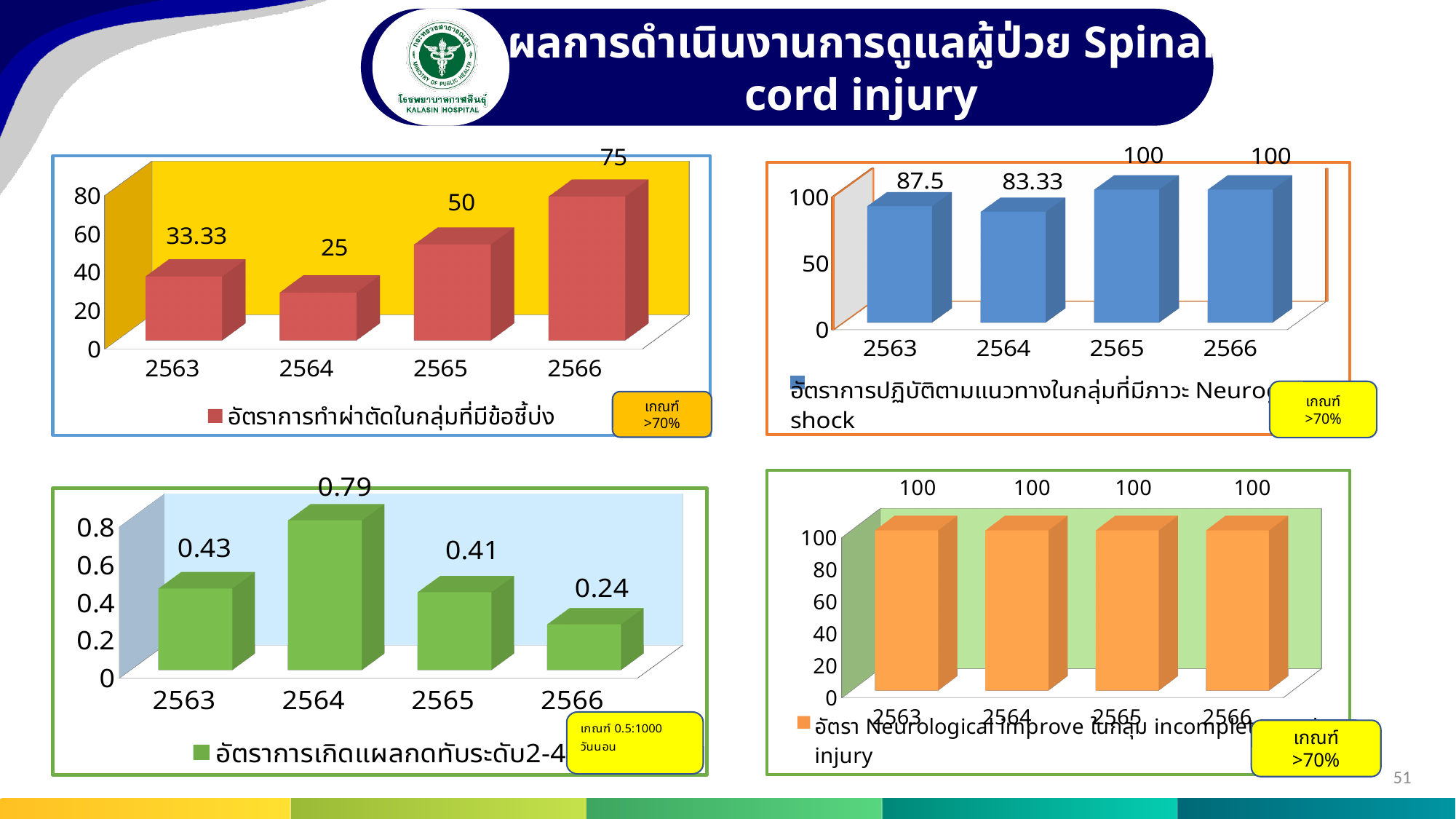
In the bottom-right chart (orange bars), what is the value for 2565? 100 In the bottom-left chart (green bars), what is the value for 2564? 0.79 In the top-right chart (blue bars), which is larger, the value for 2563 or the value for 2564? 2563 What kind of chart is the bottom-right chart (orange bars)? bar chart In the top-left chart (red bars), what is the value for 2566? 75 In the top-left chart (red bars), what is the difference between the values for 2566 and 2565? 25 In the top-right chart (blue bars), what is the value for 2564? 83.33 In the bottom-left chart (green bars), what is the difference between the values for 2563 and 2566? 0.19 In the bottom-left chart (green bars), which year has the highest value? 2564 In the top-left chart (red bars), which year has the lowest value? 2564 In the top-right chart (blue bars), how many years are shown on the x axis? 4 In the top-left chart (red bars), do the values rise or fall from 2564 to 2566? rise